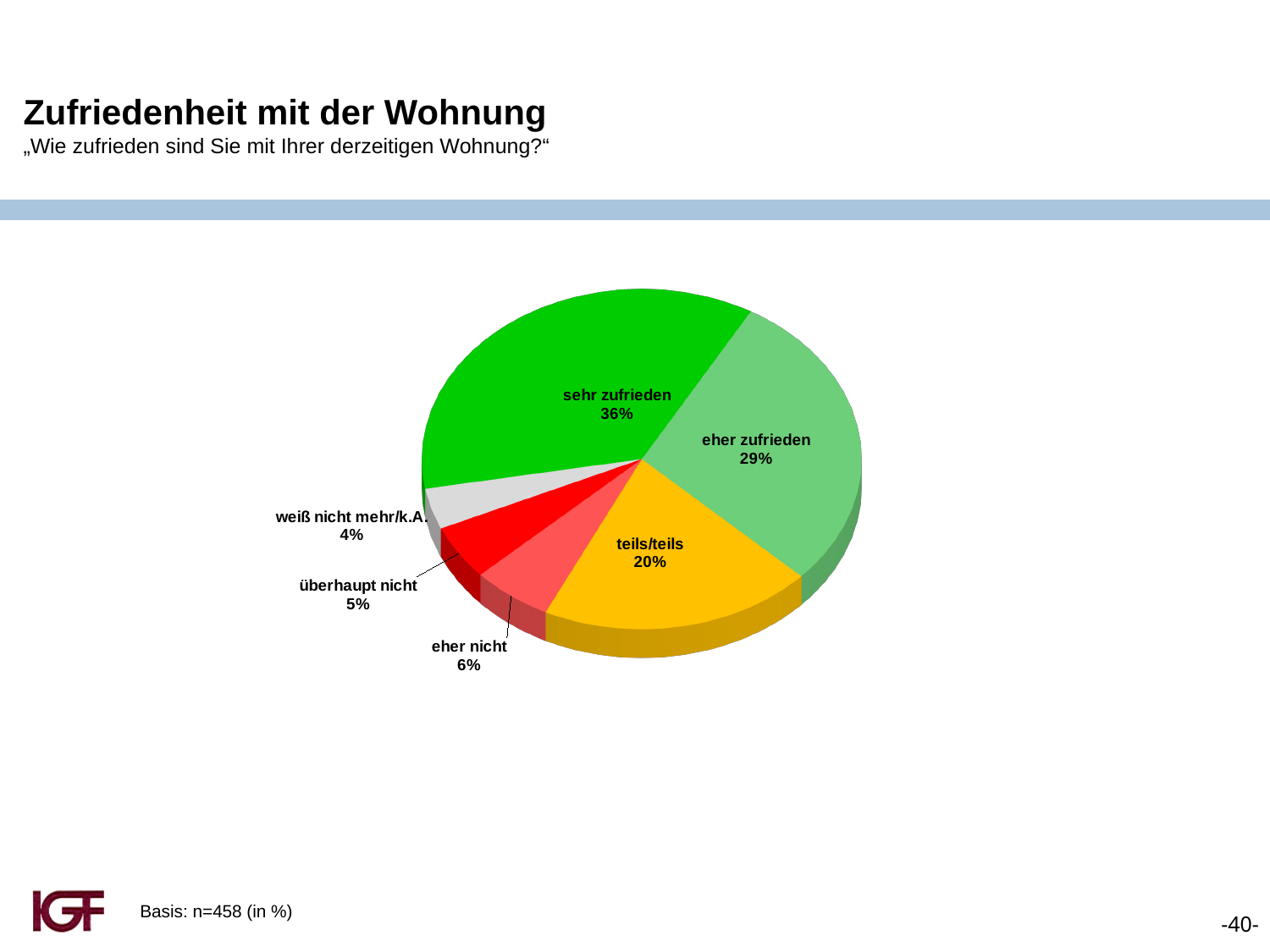
What percentage of respondents answered "eher nicht"? 6% What is the difference in percentage points between "sehr zufrieden" and "eher zufrieden"? 7 What percentage of respondents answered "sehr zufrieden"? 36% What percentage of respondents answered "eher zufrieden"? 29% Which category has the smallest share of the pie? weiß nicht mehr/k.A. What percentage of respondents answered "weiß nicht mehr/k.A."? 4% Which category has the largest share of the pie? sehr zufrieden What percentage of respondents answered "überhaupt nicht"? 5% What percentage of respondents answered "teils/teils"? 20% What kind of chart is shown on the slide? pie chart What is the title of the chart on the slide? Zufriedenheit mit der Wohnung How many categories are shown in the pie chart? 6